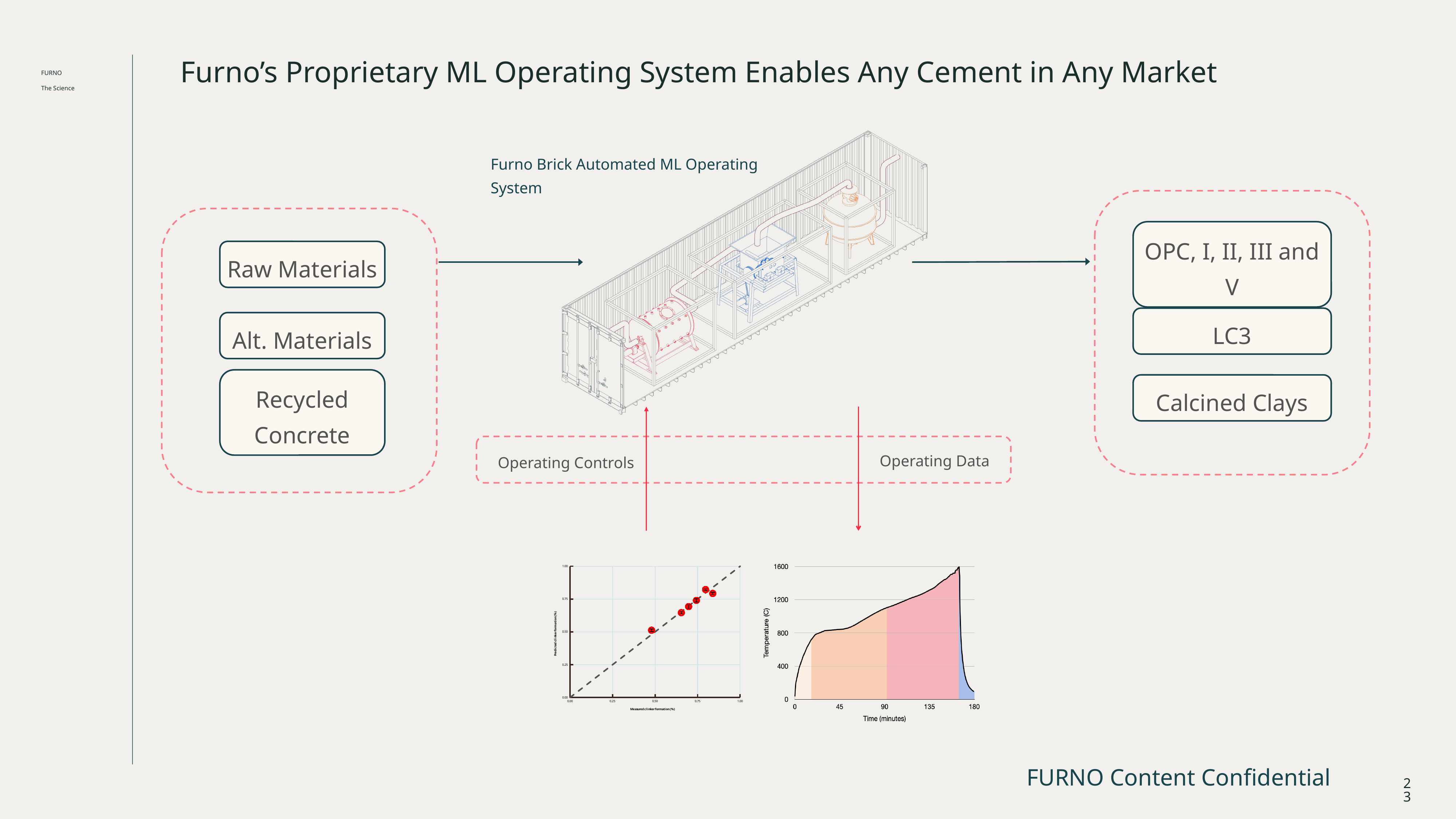
What kind of chart is the right chart at the bottom of the slide (Temperature vs Time)? line chart In the Temperature vs Time chart, what is the label of the y axis? Temperature (C) In the scatter chart of predicted vs measured clinker formation, what is the highest value shown on the x axis? 1.00 In the Temperature vs Time chart, what is the highest value shown on the y axis? 1600 In the Temperature vs Time chart, how many tick labels are shown on the x axis? 5 In the Temperature vs Time chart, is the temperature at 135 minutes greater or less than the temperature at 45 minutes? greater What kind of chart is the left chart at the bottom of the slide (predicted vs measured clinker formation)? scatter chart In the Temperature vs Time chart, what is the label of the x axis? Time (minutes) In the Temperature vs Time chart, what is the highest value shown on the x axis? 180 In the Temperature vs Time chart, is the temperature at 90 minutes greater or less than 800? greater In the Temperature vs Time chart, is the temperature at 180 minutes greater or less than 400? less In the Temperature vs Time chart, does the temperature generally rise or fall between 0 and 135 minutes? rise